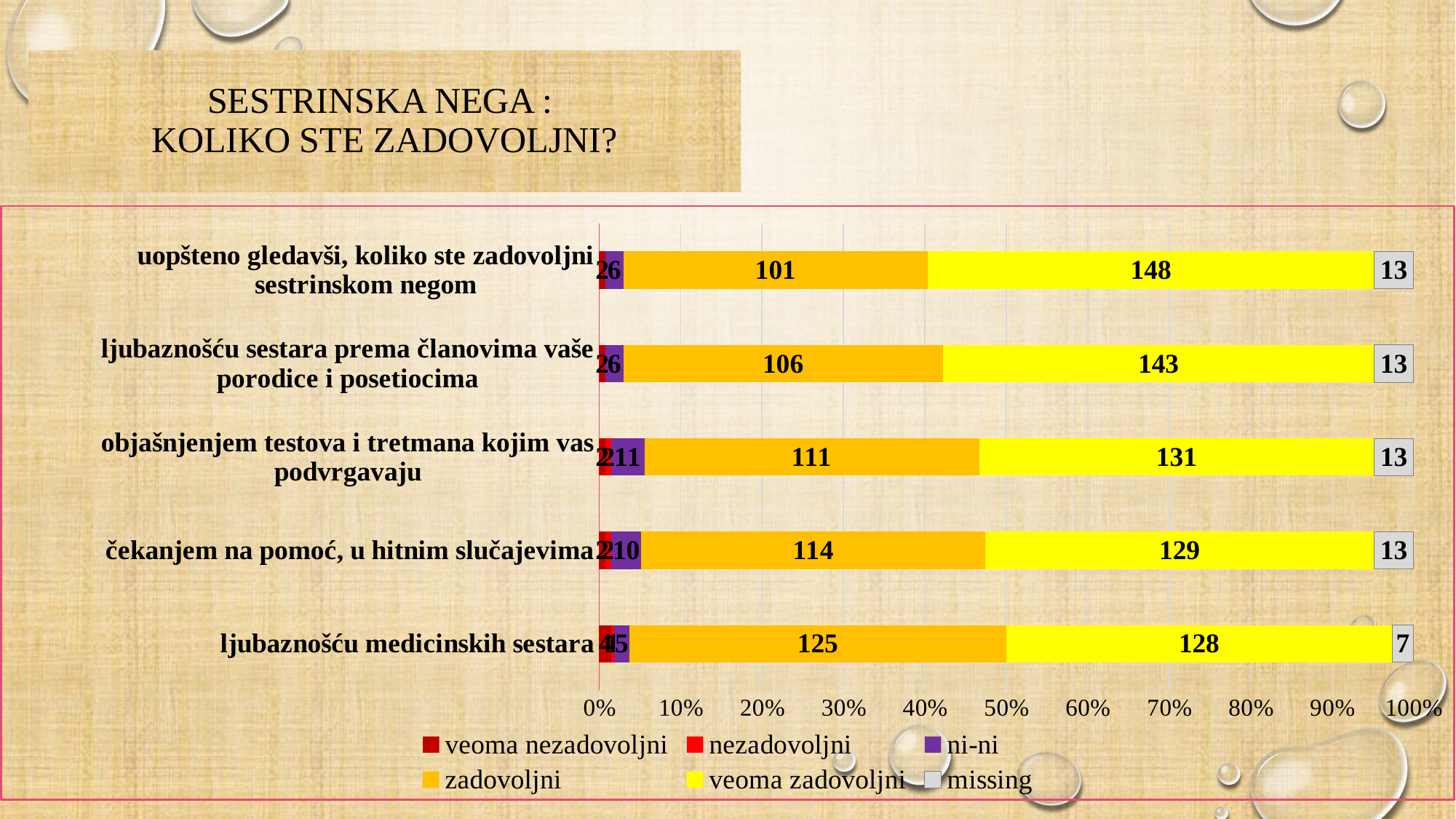
Which is larger for 'objašnjenjem testova i tretmana kojim vas podvrgavaju': the 'zadovoljni' value or the 'veoma zadovoljni' value? veoma zadovoljni What is the 'missing' value for 'ljubaznošću medicinskih sestara'? 7 What is the difference between the 'veoma zadovoljni' values for 'ljubaznošću sestara prema članovima vaše porodice i posetiocima' and 'objašnjenjem testova i tretmana kojim vas podvrgavaju'? 12 Which category has the lowest 'zadovoljni' value? uopšteno gledavši, koliko ste zadovoljni sestrinskom negom Which category has the highest 'veoma zadovoljni' value? uopšteno gledavši, koliko ste zadovoljni sestrinskom negom What is the 'veoma zadovoljni' value for 'uopšteno gledavši, koliko ste zadovoljni sestrinskom negom'? 148 What is the 'zadovoljni' value for 'čekanjem na pomoć, u hitnim slučajevima'? 114 What type of chart is shown on the slide? stacked bar chart Which colour represents the 'veoma zadovoljni' series in the legend? yellow How many categories (survey items) are shown on the chart? 5 What is the 'zadovoljni' value for 'ljubaznošću medicinskih sestara'? 125 How many series does the legend list? 6